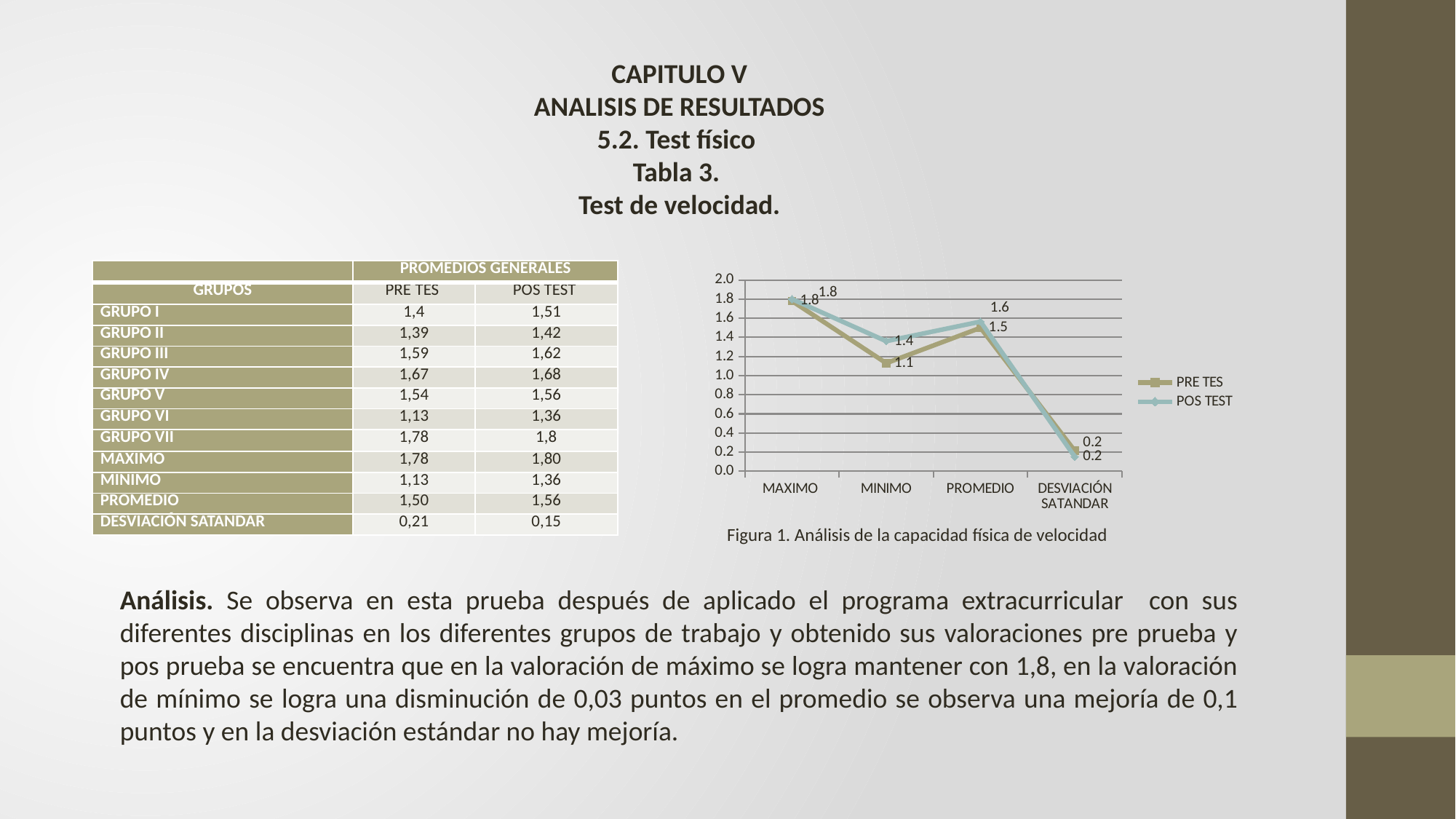
What kind of chart is shown in Figura 1? line chart What are the names of the two series in the chart legend? PRE TES and POS TEST What is the PRE TES value for PROMEDIO in the chart? 1.5 Which category has the highest value for the PRE TES series in the chart? MAXIMO For MINIMO, which series has the larger value in the chart, PRE TES or POS TEST? POS TEST What is the POS TEST value for PROMEDIO in the chart? 1.6 What is the difference between the POS TEST and PRE TES values for MINIMO in the chart? 0.3 How many categories are shown on the x axis of the chart? 4 Which category has the lowest value for the POS TEST series in the chart? DESVIACIÓN SATANDAR What is the POS TEST value for MINIMO in the chart? 1.4 How many series does the legend of the chart list? 2 What is the PRE TES value for MINIMO in the chart? 1.1